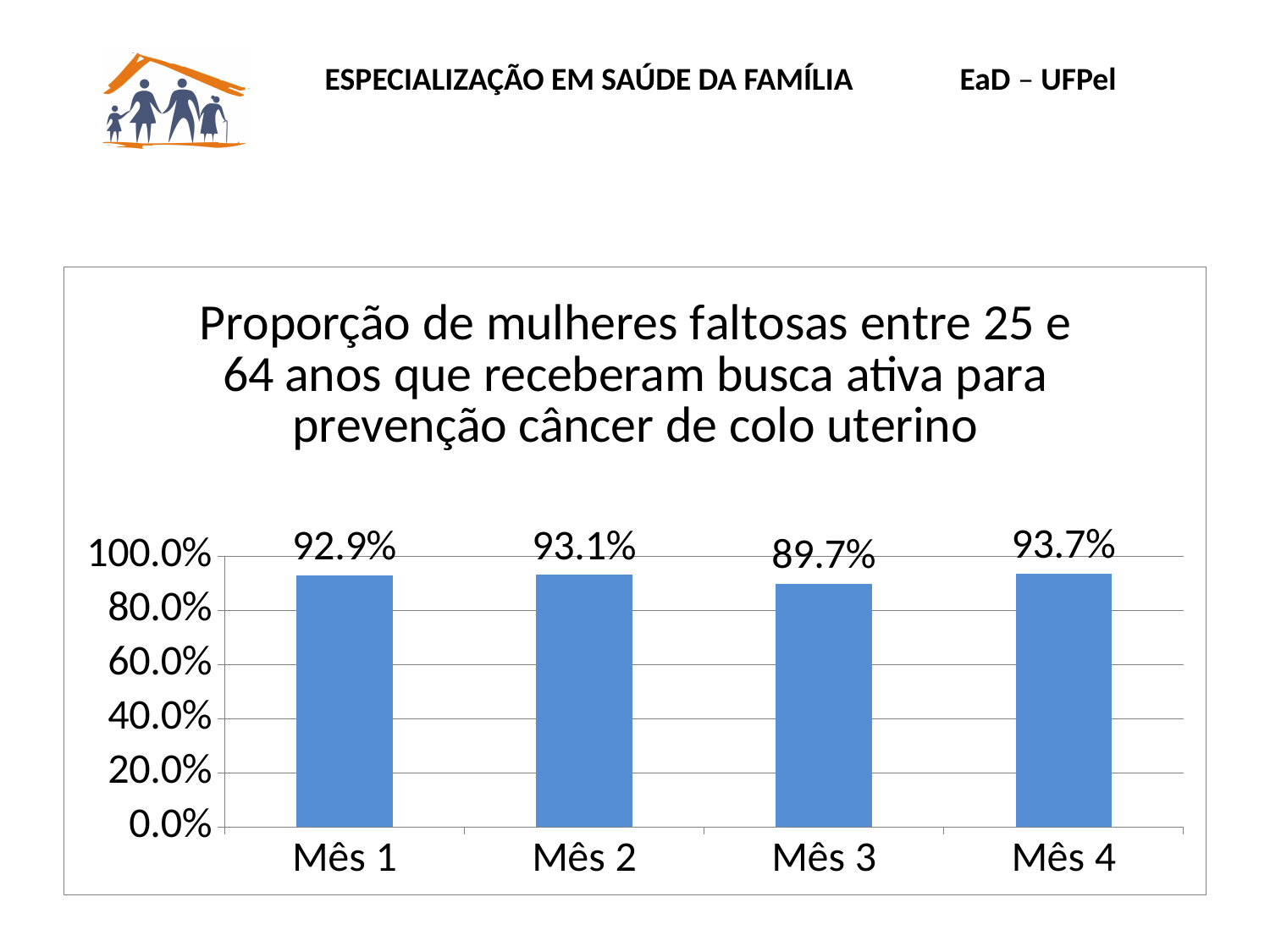
What is the title of the chart? Proporção de mulheres faltosas entre 25 e 64 anos que receberam busca ativa para prevenção câncer de colo uterino Which month has the lowest value? Mês 3 What is the value for Mês 1? 92.9% What kind of chart is shown on the slide? bar chart Is the value for Mês 3 greater or less than 80.0%? greater What is the value for Mês 4? 93.7% Which is larger, the value for Mês 2 or the value for Mês 3? Mês 2 How many months are shown on the x axis? 4 What is the difference between the values for Mês 4 and Mês 3? 4.0% Which month has the highest value? Mês 4 What is the value for Mês 3? 89.7% What is the difference between the values for Mês 2 and Mês 1? 0.2%